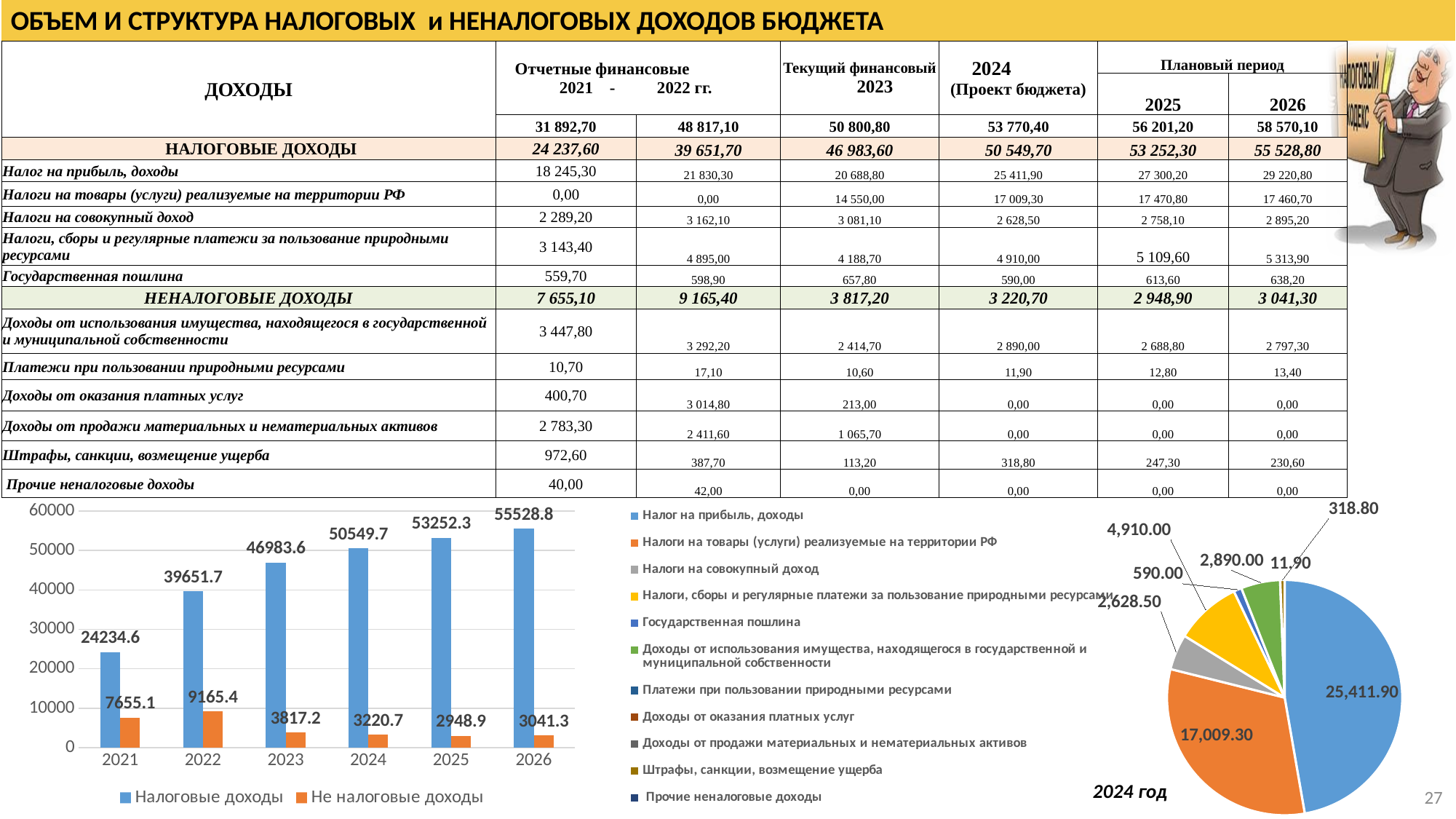
In the bar chart, which year has the highest value for Налоговые доходы? 2026 In the bar chart, what is the value of Не налоговые доходы for 2022? 9165.4 In the pie chart for 2024 год, what is the value of the largest slice? 25,411.90 What kind of chart is the chart at the bottom right of the slide? pie chart In the bar chart, do the values for Налоговые доходы rise or fall from 2021 to 2026? rise In the bar chart, what is the value of Налоговые доходы for 2023? 46983.6 How many series does the legend of the bar chart list? 2 How many years are shown on the x axis of the bar chart? 6 In the bar chart, which year has the lowest value for Не налоговые доходы? 2025 What kind of chart is the chart at the bottom left of the slide? bar chart In the bar chart, is the value of Не налоговые доходы larger in 2021 or in 2022? 2022 In the bar chart, what is the difference between Налоговые доходы and Не налоговые доходы in 2026? 52487.5